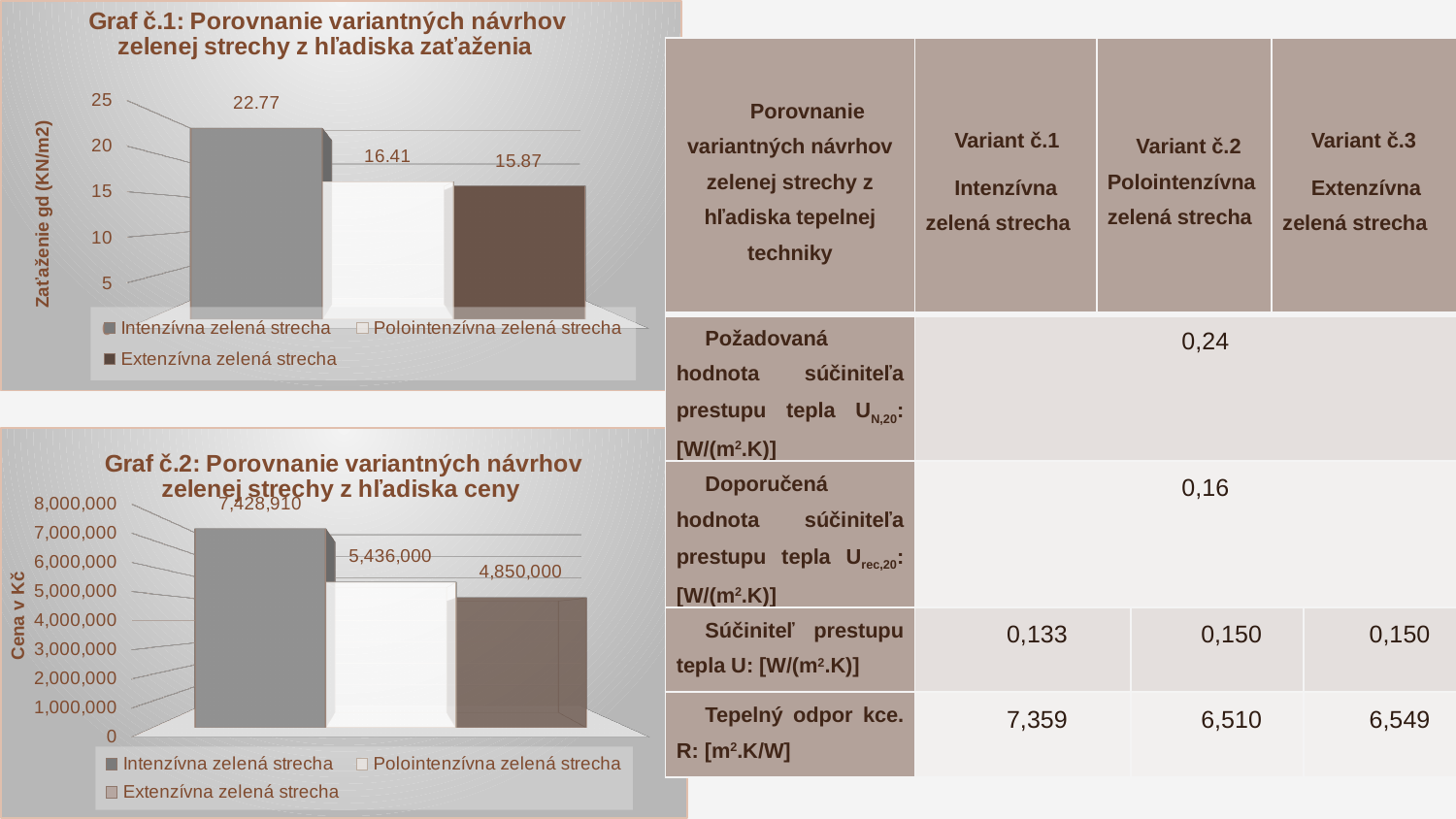
In Graf č.2, what is the value for Polointenzívna zelená strecha? 5,436,000 In Graf č.1, what is the value for Extenzívna zelená strecha? 15.87 In Graf č.2, which series has the lowest value? Extenzívna zelená strecha In Graf č.1, which series has the highest value? Intenzívna zelená strecha What kind of chart is Graf č.2? Bar chart In Graf č.2, what is the value for Extenzívna zelená strecha? 4,850,000 In Graf č.1, what is the difference between the values for Intenzívna zelená strecha and Extenzívna zelená strecha? 6.9 In Graf č.2, what is the difference between the values for Polointenzívna zelená strecha and Extenzívna zelená strecha? 586,000 In Graf č.1, how many series does the legend list? 3 In Graf č.1, what is the value for Intenzívna zelená strecha? 22.77 In Graf č.1, what is the value for Polointenzívna zelená strecha? 16.41 In Graf č.2, what is the value for Intenzívna zelená strecha? 7,428,910